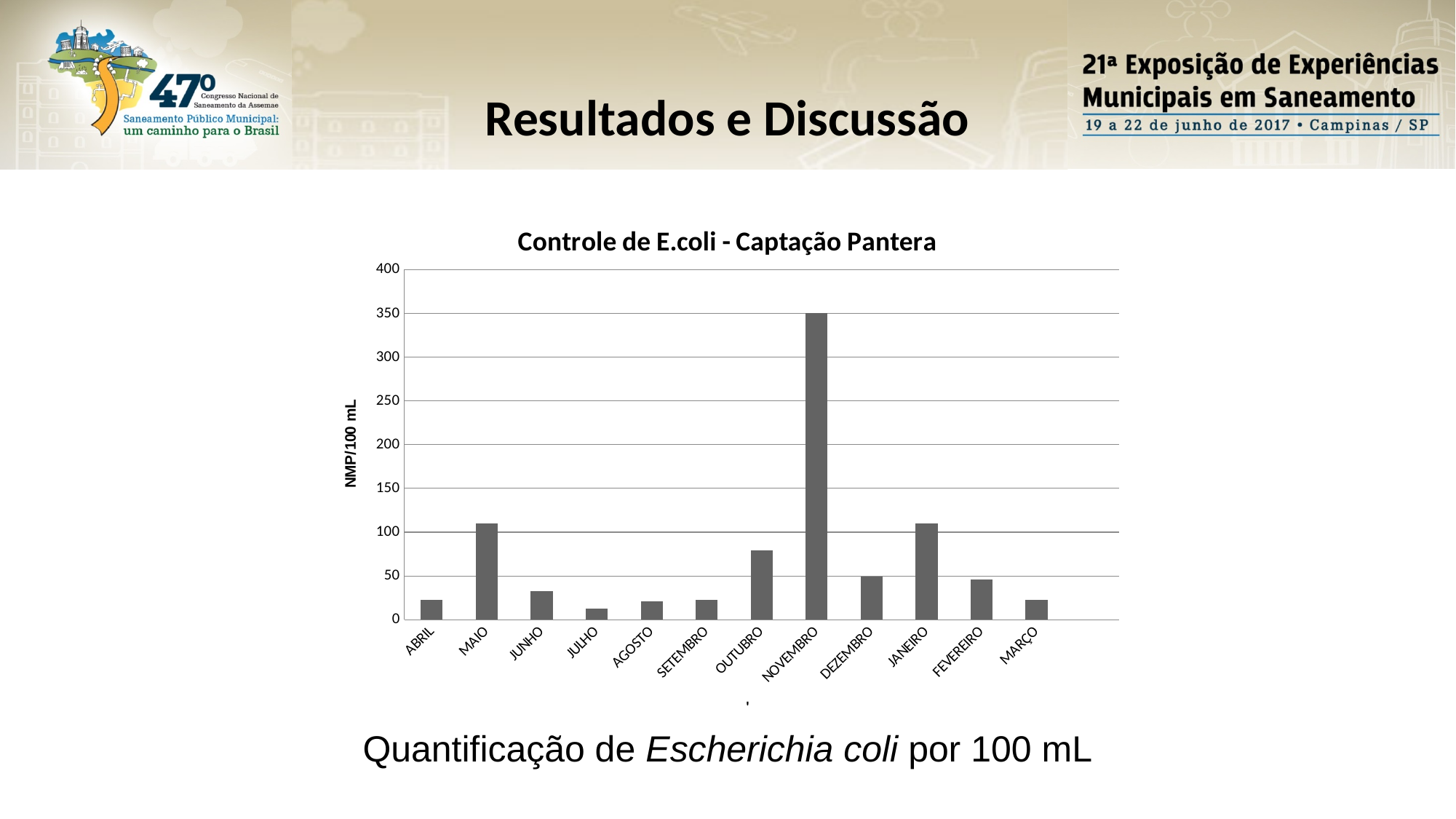
Which month has the highest value in the chart? NOVEMBRO Is the value for JULHO greater or less than 50? less Which month has the lowest value in the chart? JULHO Which is larger, the value for JANEIRO or the value for FEVEREIRO? JANEIRO What is the label of the vertical axis? NMP/100 mL Which is larger, the value for OUTUBRO or the value for DEZEMBRO? OUTUBRO What type of chart is shown on the slide? bar chart Is the value for MAIO greater or less than 100? greater What is the value for NOVEMBRO? 350 Is the value for OUTUBRO greater or less than 100? less How many months are shown on the x axis of the chart? 12 What is the title of the chart? Controle de E.coli - Captação Pantera